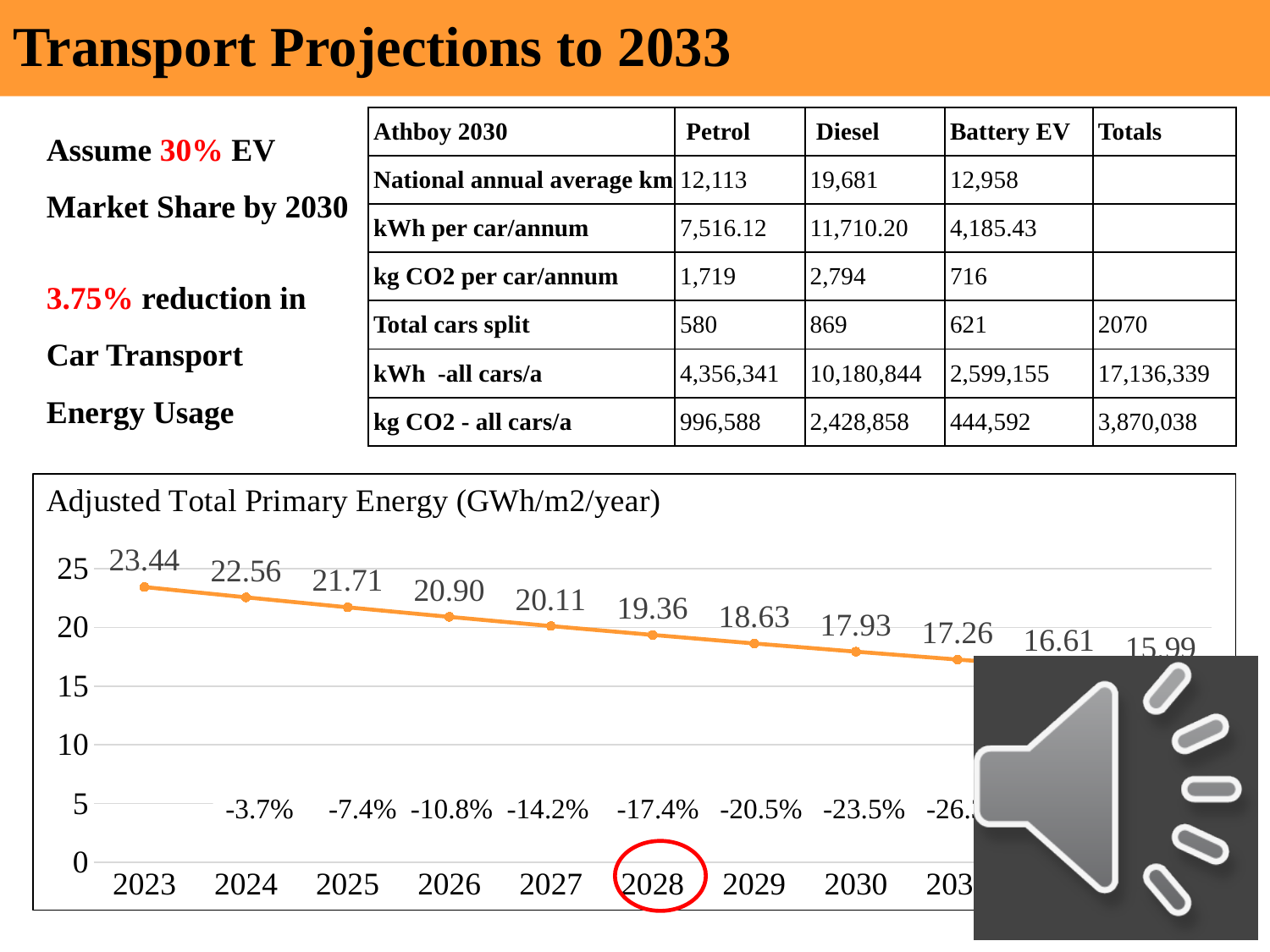
What percentage change is shown for 2029 in the Adjusted Total Primary Energy chart? -20.5% What is the difference between the 2025 and 2030 values in the Adjusted Total Primary Energy chart? 3.78 Do the Adjusted Total Primary Energy values rise or fall from 2023 onwards? fall What is the Adjusted Total Primary Energy value for 2023? 23.44 What is the title of the chart on the slide? Adjusted Total Primary Energy (GWh/m2/year) What is the Adjusted Total Primary Energy value for 2028? 19.36 What is the Adjusted Total Primary Energy value for 2030? 17.93 What kind of chart is the Adjusted Total Primary Energy chart? line chart What percentage change is shown for 2026 in the Adjusted Total Primary Energy chart? -10.8% Which year shown has the highest Adjusted Total Primary Energy value? 2023 What is the difference between the 2023 and 2024 values in the Adjusted Total Primary Energy chart? 0.88 Which year has a higher Adjusted Total Primary Energy value, 2026 or 2029? 2026